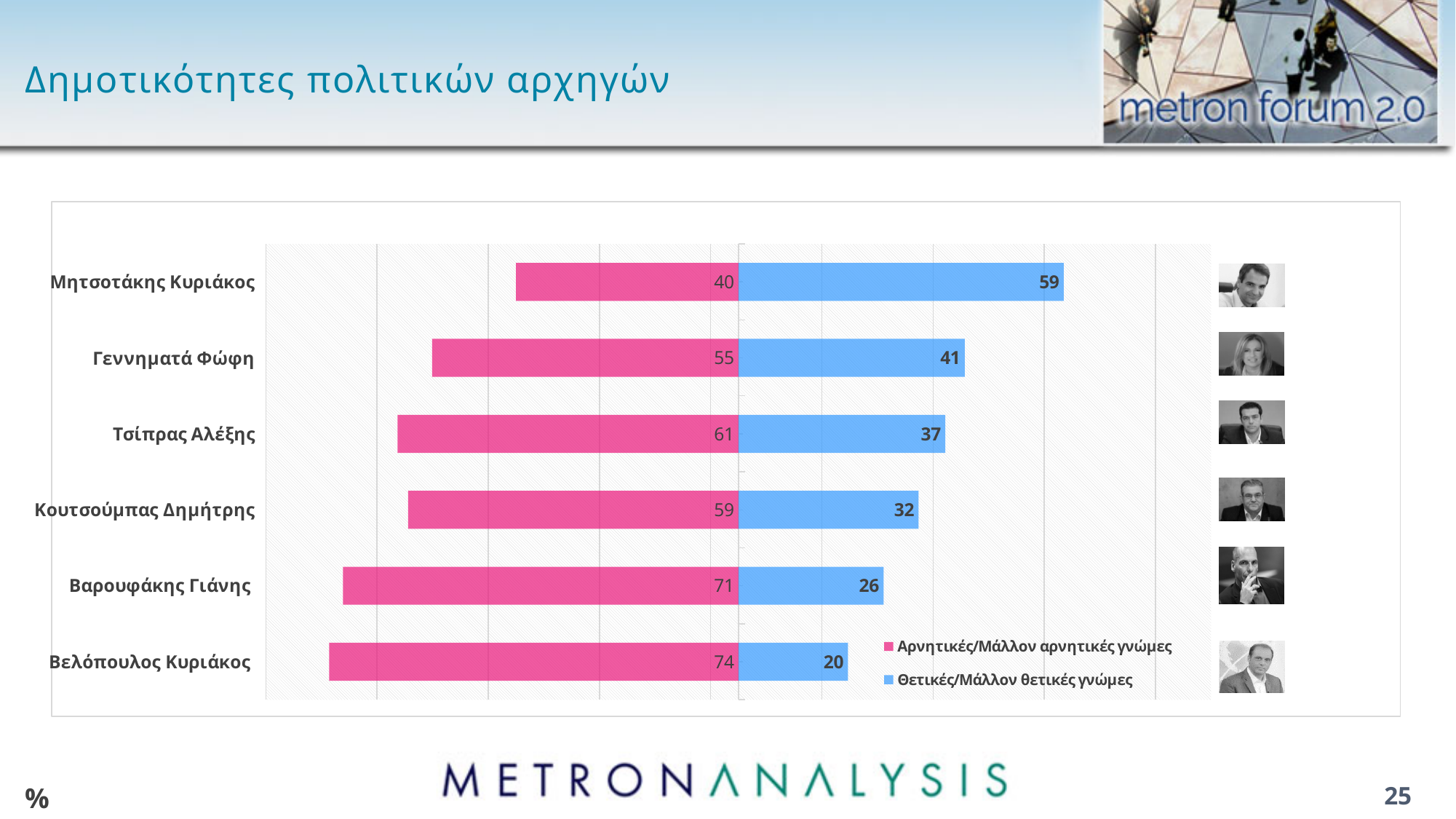
How many leaders are shown in the chart? 6 How many series does the legend list? 2 Which leader has the highest value for Θετικές/Μάλλον θετικές γνώμες? Μητσοτάκης Κυριάκος Which is larger: the Θετικές/Μάλλον θετικές γνώμες value for Γεννηματά Φώφη or for Τσίπρας Αλέξης? Γεννηματά Φώφη What is the value of Θετικές/Μάλλον θετικές γνώμες for Κουτσούμπας Δημήτρης? 32 What is the value of Θετικές/Μάλλον θετικές γνώμες for Μητσοτάκης Κυριάκος? 59 What is the value of Αρνητικές/Μάλλον αρνητικές γνώμες for Βελόπουλος Κυριάκος? 74 Which leader has the lowest value for Αρνητικές/Μάλλον αρνητικές γνώμες? Μητσοτάκης Κυριάκος What is the value of Αρνητικές/Μάλλον αρνητικές γνώμες for Τσίπρας Αλέξης? 61 Which colour represents Αρνητικές/Μάλλον αρνητικές γνώμες in the chart? Pink What is the difference between the Αρνητικές/Μάλλον αρνητικές γνώμες values for Βαρουφάκης Γιάνης and Γεννηματά Φώφη? 16 What kind of chart is shown on the slide? Bar chart